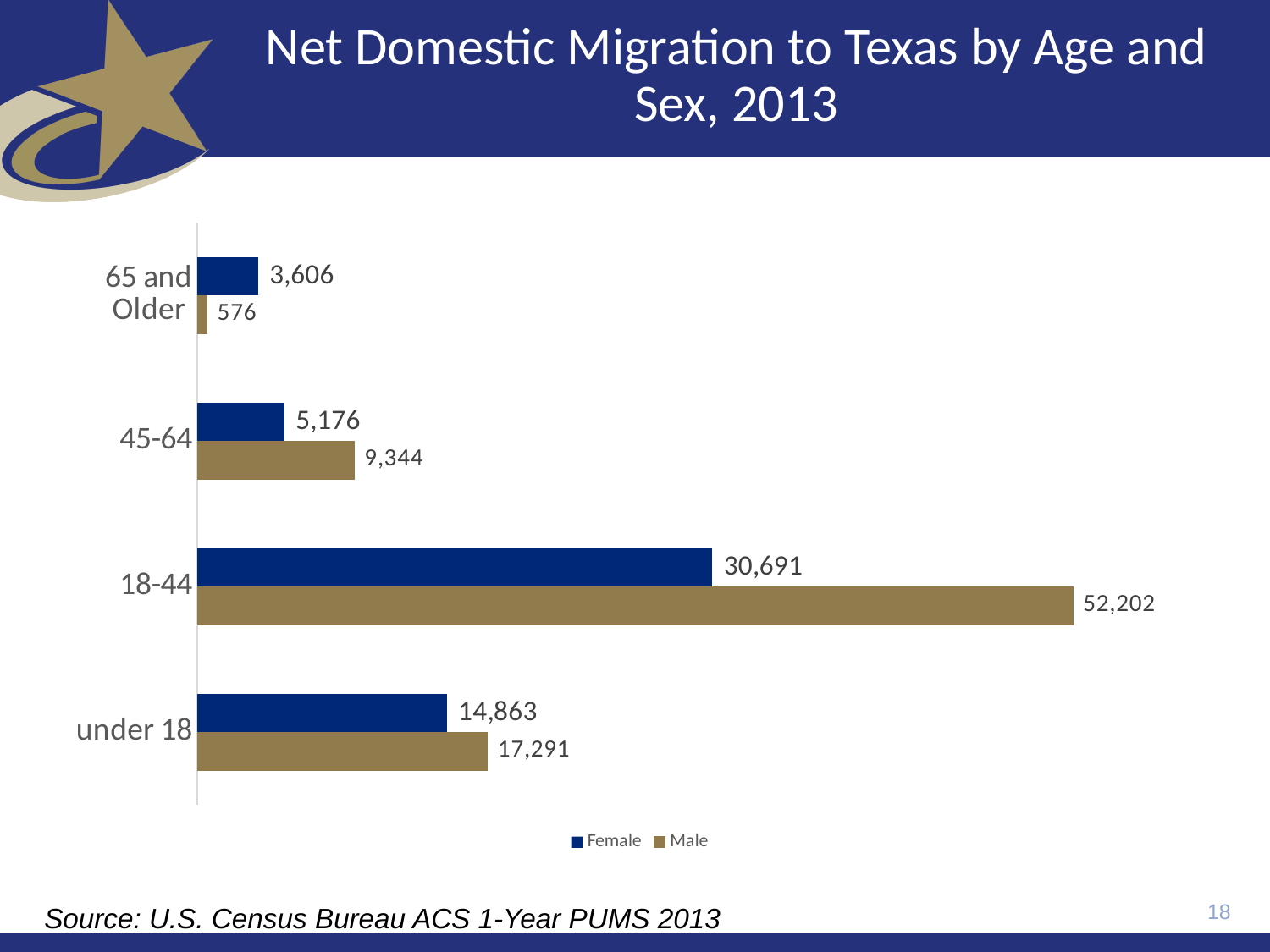
How many age groups are shown on the chart? 4 What is the difference between the Male and Female values for the 45-64 age group? 4,168 What kind of chart is shown on the slide? Bar chart What is the title of the chart? Net Domestic Migration to Texas by Age and Sex, 2013 Which age group has the highest Male value? 18-44 What is the Male value for the under 18 age group? 17,291 What is the Male value for the 65 and Older age group? 576 How many series does the legend list? 2 What is the Female value for the 18-44 age group? 30,691 Which age group has the lowest Female value? 65 and Older What is the difference between the Male and Female values for the 18-44 age group? 21,511 For the 65 and Older age group, which is larger, the Female value or the Male value? Female